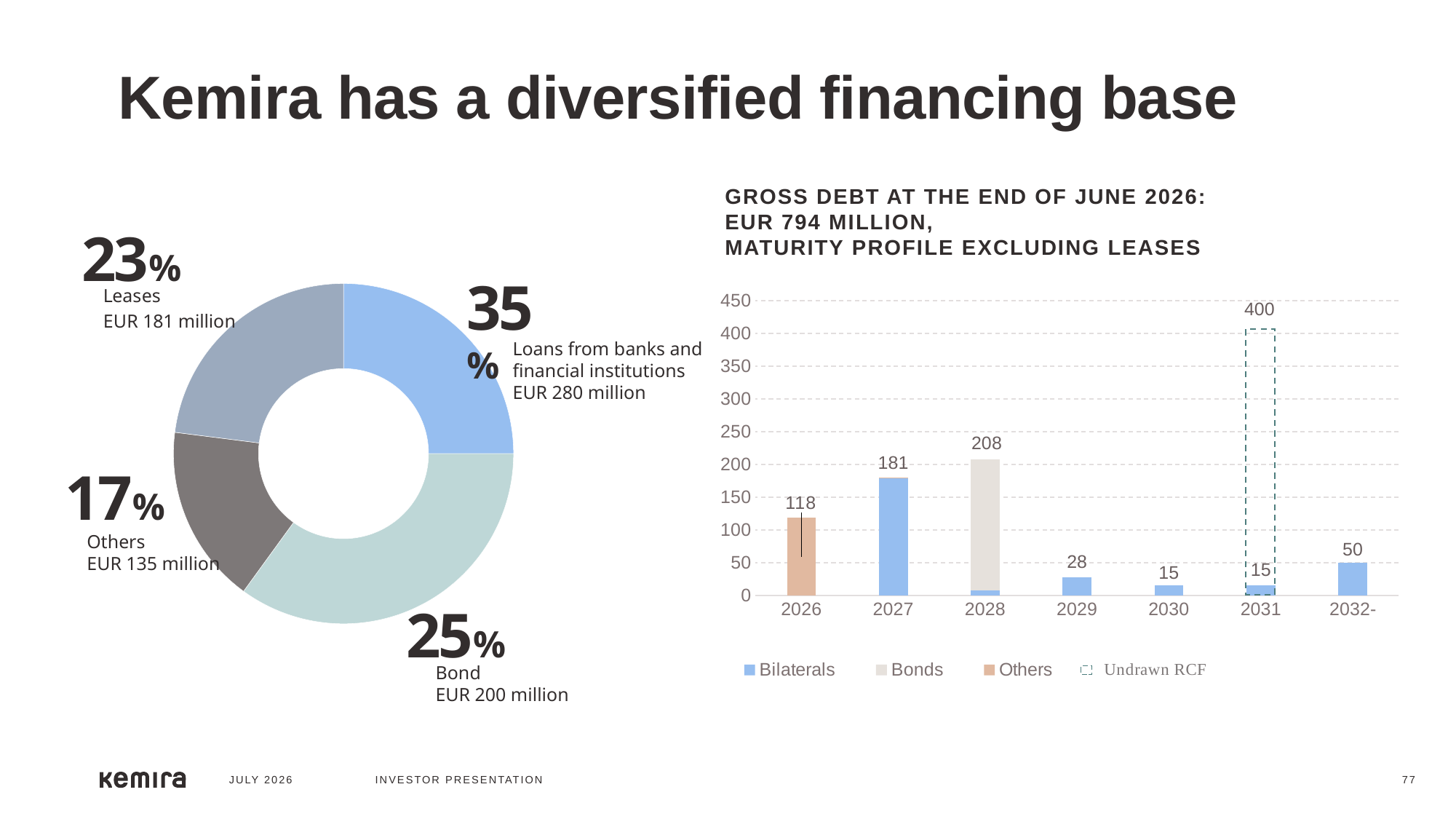
In the gross debt maturity profile chart, what is the difference between the 2027 and 2026 values? 63 In the gross debt maturity profile chart, what is the value for 2028? 208 In the gross debt maturity profile chart, what is the value for 2032-? 50 In the donut chart on the left, what share of the financing base is Leases? 23% In the donut chart on the left, how many categories are shown? 4 In the donut chart on the left, what is the difference in EUR million between Loans from banks and financial institutions and Others? EUR 145 million In the gross debt maturity profile chart, how many series does the legend list? 4 In the donut chart on the left, which category has the largest share? Loans from banks and financial institutions In the donut chart on the left, which category has the smallest share? Others In the gross debt maturity profile chart, which year has the highest debt maturity (excluding the undrawn RCF)? 2028 In the donut chart on the left, what is the value for Bond? EUR 200 million In the gross debt maturity profile chart, what is the value of the Undrawn RCF shown in 2031? 400